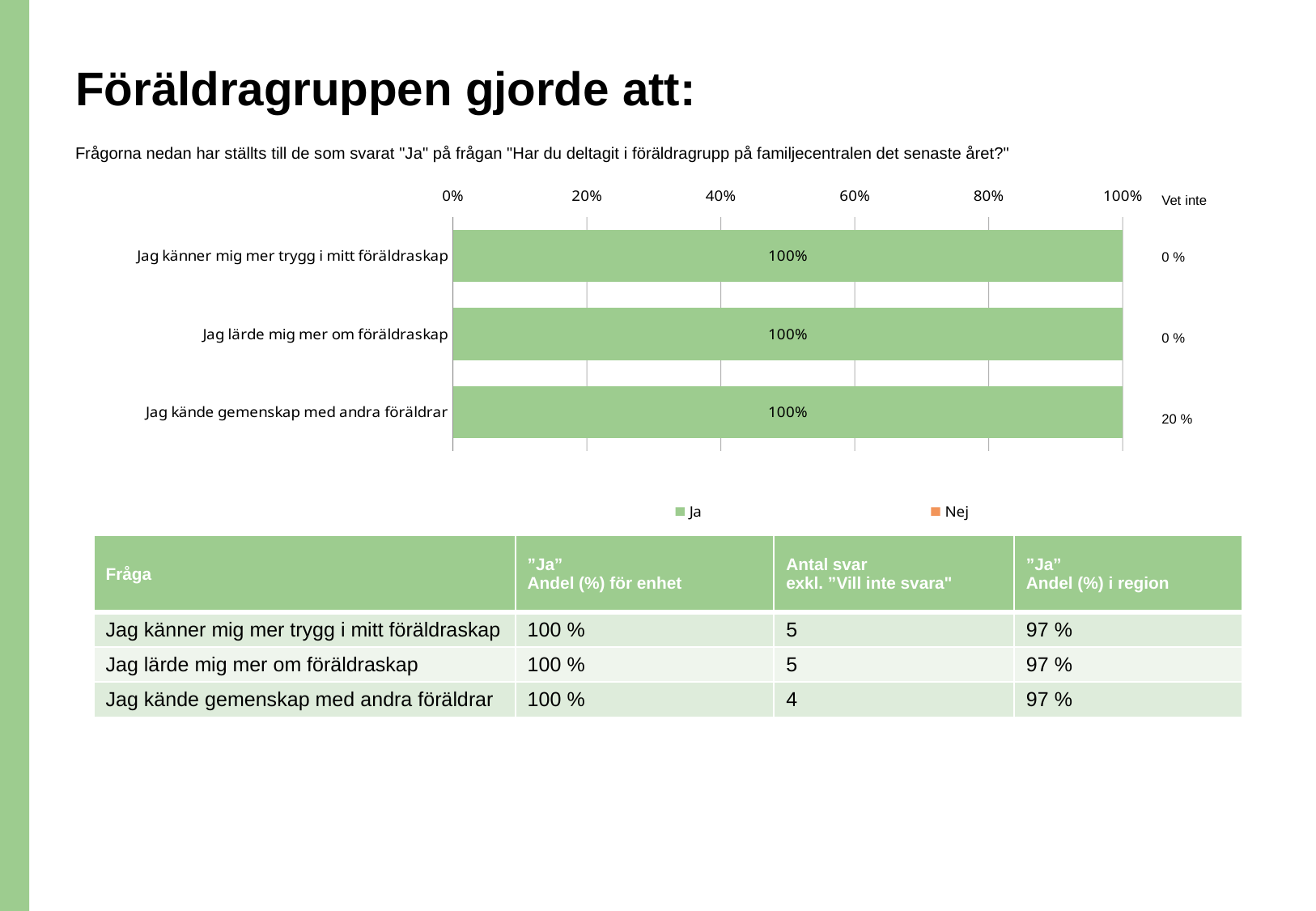
What is the "Vet inte" value shown next to the bar for "Jag kände gemenskap med andra föräldrar"? 20 % How many series does the chart legend list? 2 What colour are the "Ja" bars in the chart? green Which two series are listed in the chart legend? Ja and Nej What kind of chart is shown on the slide? bar chart How many categories (statements) are plotted in the chart? 3 What is the difference between the "Ja" values for "Jag känner mig mer trygg i mitt föräldraskap" and "Jag lärde mig mer om föräldraskap"? 0% What is the "Ja" value for "Jag kände gemenskap med andra föräldrar"? 100% What is the "Ja" value for "Jag känner mig mer trygg i mitt föräldraskap"? 100% What is the "Ja" value for "Jag lärde mig mer om föräldraskap"? 100% Is the "Ja" value for "Jag kände gemenskap med andra föräldrar" greater or less than 80%? greater What is the "Vet inte" value shown next to the bar for "Jag lärde mig mer om föräldraskap"? 0 %